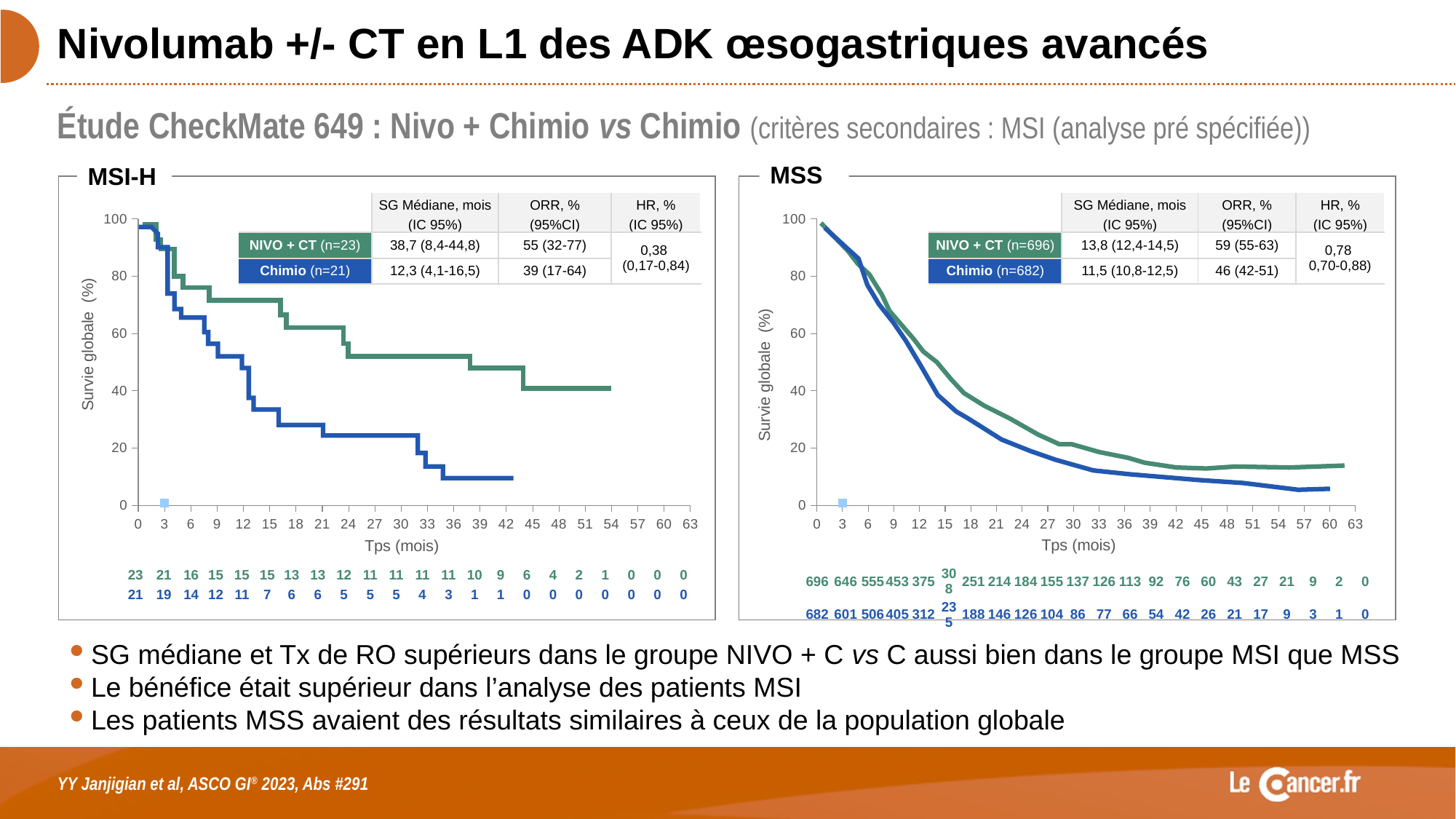
In the MSS chart, what is the median overall survival (SG médiane) for the Chimio arm? 11,5 (10,8-12,5) In the MSS chart, is the NIVO + CT survival at 30 months greater or less than 40? less In the MSI-H chart, how many Chimio patients are at risk at 3 months? 19 In the MSI-H chart, what is the difference in ORR between NIVO + CT (55) and Chimio (39)? 16 How many series (treatment arms) are plotted in the MSS chart? 2 In the MSI-H chart, what is the median overall survival (SG médiane) for NIVO + CT? 38,7 (8,4-44,8) In the MSI-H chart, is the Chimio survival at 36 months greater or less than 20? less In the MSS chart, how many patients are in the NIVO + CT arm? 696 In the MSS chart, what is the hazard ratio (HR) shown in the table? 0,78 (0,70-0,88) In the MSI-H chart, what is the ORR for the Chimio arm? 39 (17-64) In the MSS chart, do the survival curves rise or fall as time (Tps, mois) increases? fall In the MSI-H chart, which arm has the higher ORR, NIVO + CT or Chimio? NIVO + CT